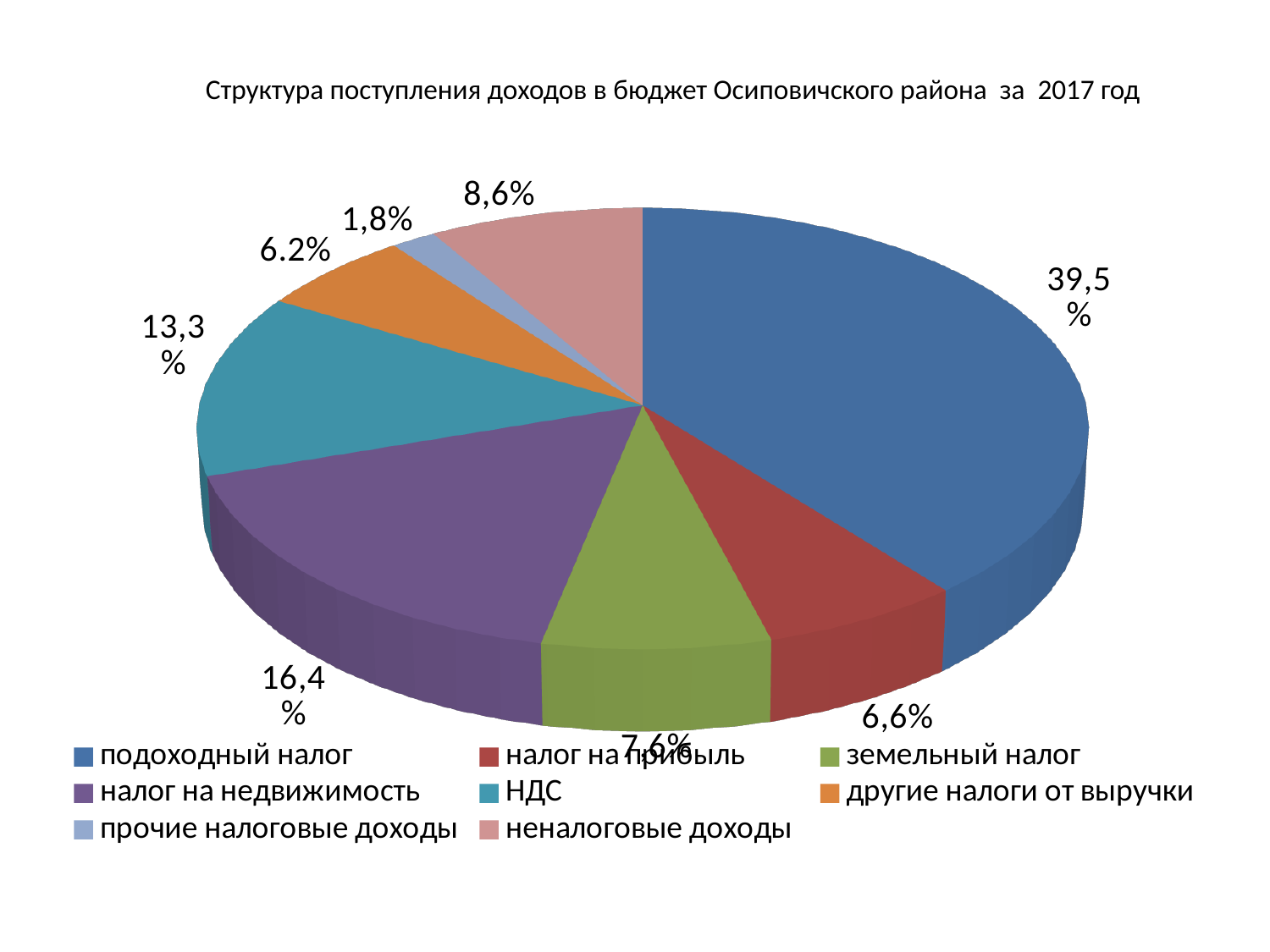
Which category has the smallest share of the pie? прочие налоговые доходы What share of the pie does неналоговые доходы have? 8,6% What share of the pie does налог на недвижимость have? 16,4% What share of the pie does НДС have? 13,3% Which category has the largest share of the pie? подоходный налог How many categories does the pie chart have? 8 Which is larger, the share for налог на недвижимость or the share for НДС? налог на недвижимость What is the title of the chart? Структура поступления доходов в бюджет Осиповичского района за 2017 год What kind of chart is shown on the slide? pie chart What is the difference between the share for подоходный налог and the share for налог на недвижимость? 23,1%